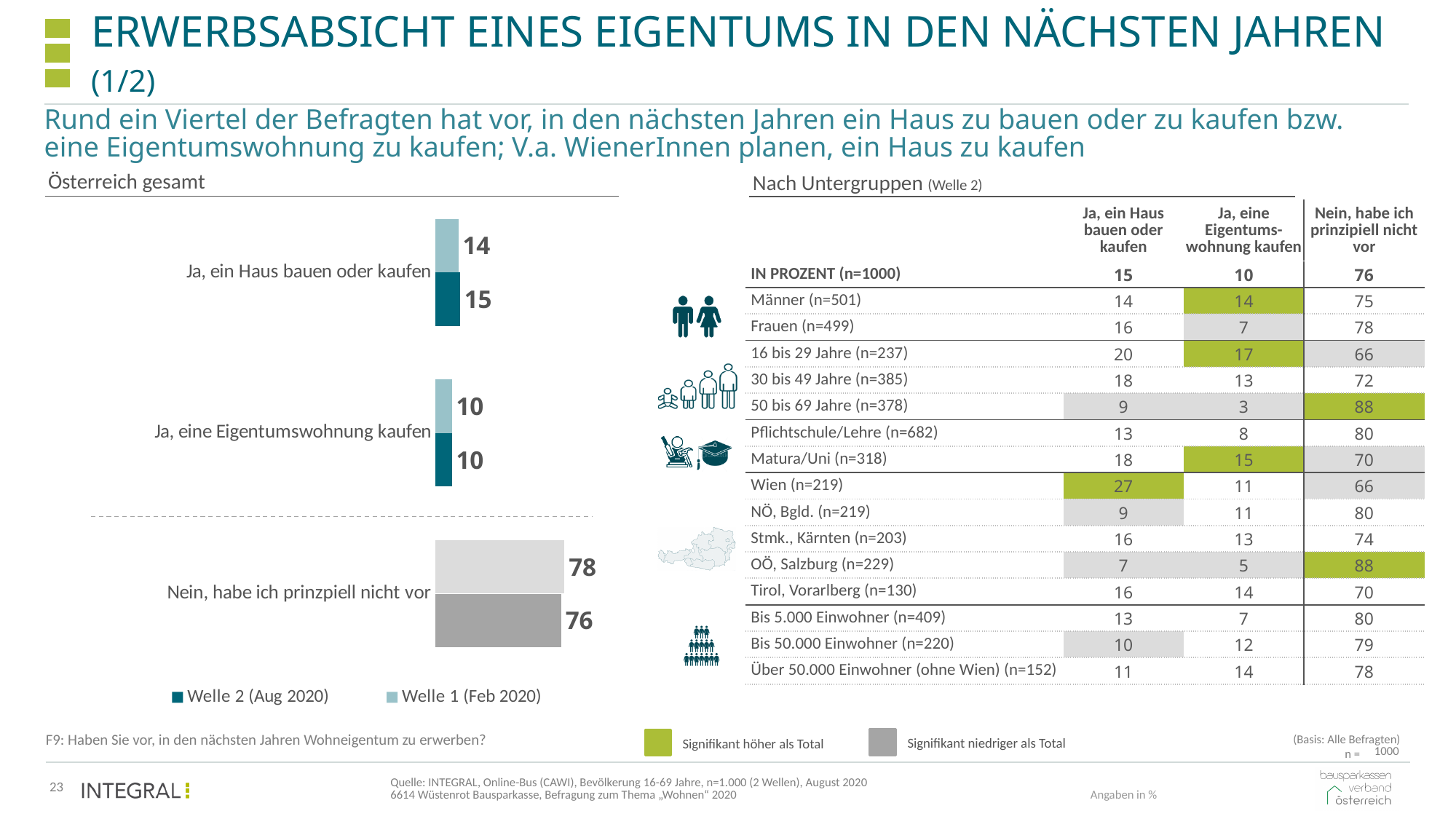
In the "Österreich gesamt" chart, what is the Welle 2 (Aug 2020) value for "Ja, ein Haus bauen oder kaufen"? 15 How many series does the legend of the "Österreich gesamt" chart list? 2 What type of chart is the "Österreich gesamt" chart? Bar chart In the "Österreich gesamt" chart, what is the Welle 1 (Feb 2020) value for "Ja, ein Haus bauen oder kaufen"? 14 In the "Österreich gesamt" chart, what is the Welle 2 (Aug 2020) value for "Ja, eine Eigentumswohnung kaufen"? 10 In the "Österreich gesamt" chart, which category has the highest Welle 2 (Aug 2020) value? Nein, habe ich prinzpiell nicht vor In the "Österreich gesamt" chart, is the Welle 2 (Aug 2020) value for "Ja, ein Haus bauen oder kaufen" larger or smaller than the Welle 1 (Feb 2020) value? larger How many categories are shown in the "Österreich gesamt" chart? 3 In the "Österreich gesamt" chart, what is the difference between the Welle 1 and Welle 2 values for "Nein, habe ich prinzpiell nicht vor"? 2 In the "Österreich gesamt" chart, what is the Welle 2 (Aug 2020) value for "Nein, habe ich prinzpiell nicht vor"? 76 In the "Österreich gesamt" chart, which category has the lowest Welle 2 (Aug 2020) value? Ja, eine Eigentumswohnung kaufen In the "Österreich gesamt" chart, what is the Welle 1 (Feb 2020) value for "Nein, habe ich prinzpiell nicht vor"? 78